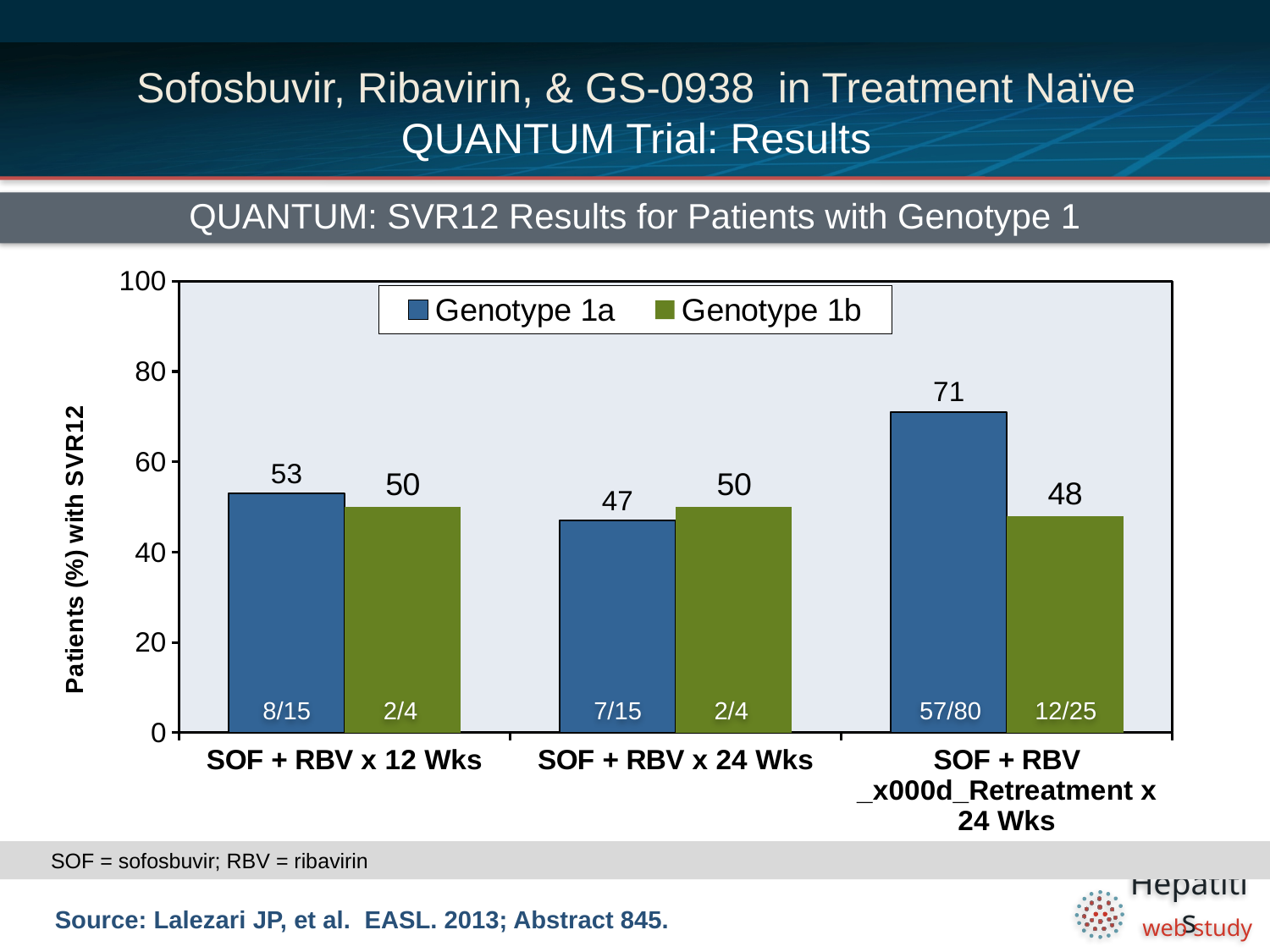
What is the SVR12 rate for Genotype 1a in the SOF + RBV x 12 Wks group? 53 How many treatment groups are shown on the x axis? 3 In the SOF + RBV x 24 Wks group, which genotype has the higher SVR12 rate? Genotype 1b What is the SVR12 rate for Genotype 1b in the SOF + RBV x 24 Wks group? 50 What kind of chart is shown on the slide? Bar chart What fraction of patients is printed inside the Genotype 1a bar for SOF + RBV Retreatment x 24 Wks? 57/80 What is the difference between the Genotype 1a and Genotype 1b SVR12 rates in the SOF + RBV Retreatment x 24 Wks group? 23 Is the Genotype 1a value for SOF + RBV Retreatment x 24 Wks greater or less than 60? greater Which treatment group has the highest SVR12 rate for Genotype 1a? SOF + RBV Retreatment x 24 Wks Which treatment group has the lowest SVR12 rate for Genotype 1a? SOF + RBV x 24 Wks How many series does the legend list? 2 What is the SVR12 rate for Genotype 1a in the SOF + RBV Retreatment x 24 Wks group? 71